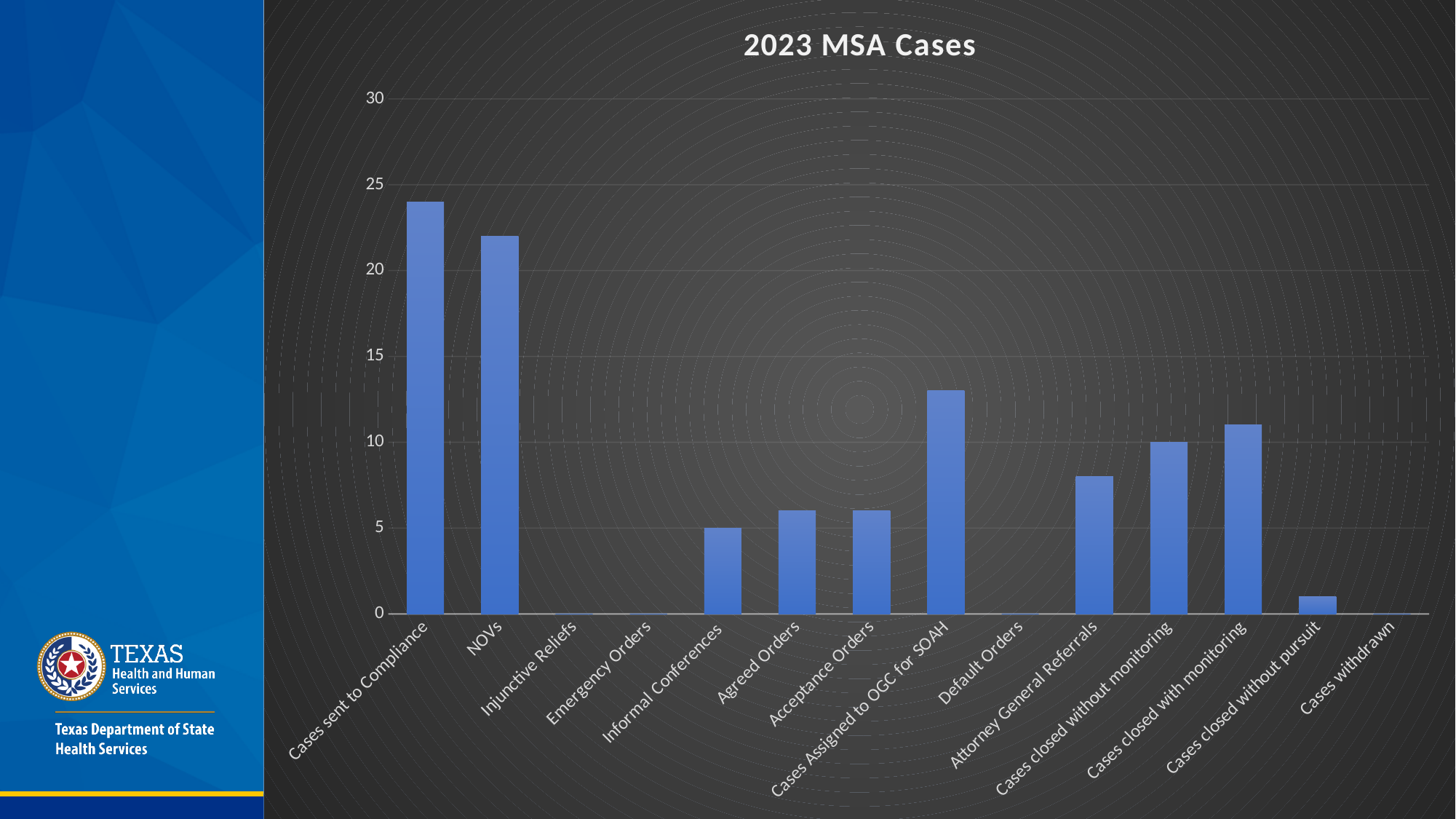
What is the title of the chart? 2023 MSA Cases Is the value for Attorney General Referrals greater or less than 10? less Which is larger, the value for Cases sent to Compliance or the value for NOVs? Cases sent to Compliance Is the value for Cases closed without pursuit greater or less than 5? less Is the value for NOVs greater or less than 25? less What is the value for Informal Conferences? 5 Which is larger, the value for Cases Assigned to OGC for SOAH or the value for Attorney General Referrals? Cases Assigned to OGC for SOAH Which category has the highest value in the chart? Cases sent to Compliance How many categories are shown on the x axis of the chart? 14 What kind of chart is shown on the slide? bar chart